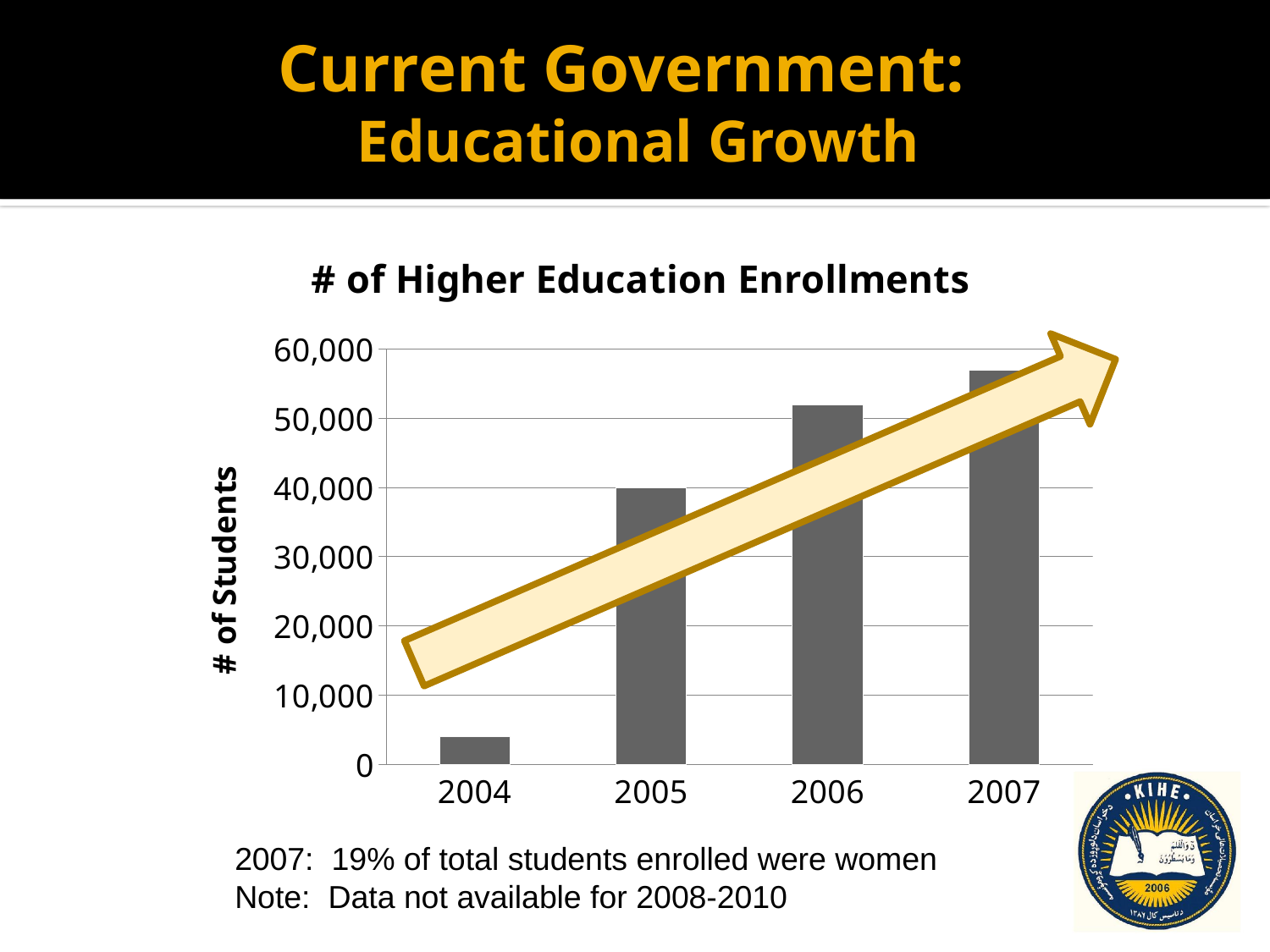
Is the value for 2006 greater or less than 50,000? greater What is the title of the chart? # of Higher Education Enrollments Is the value for 2007 greater or less than 60,000? less Which year has more enrollments, 2005 or 2006? 2006 Is the value for 2004 greater or less than 10,000? less Which year has the lowest number of higher education enrollments? 2004 How many years are shown on the x axis of the chart? 4 What is the label on the y axis of the chart? # of Students Which year has the highest number of higher education enrollments? 2007 Do the enrollment values rise or fall from 2004 to 2007? rise What kind of chart is shown on the slide? bar chart